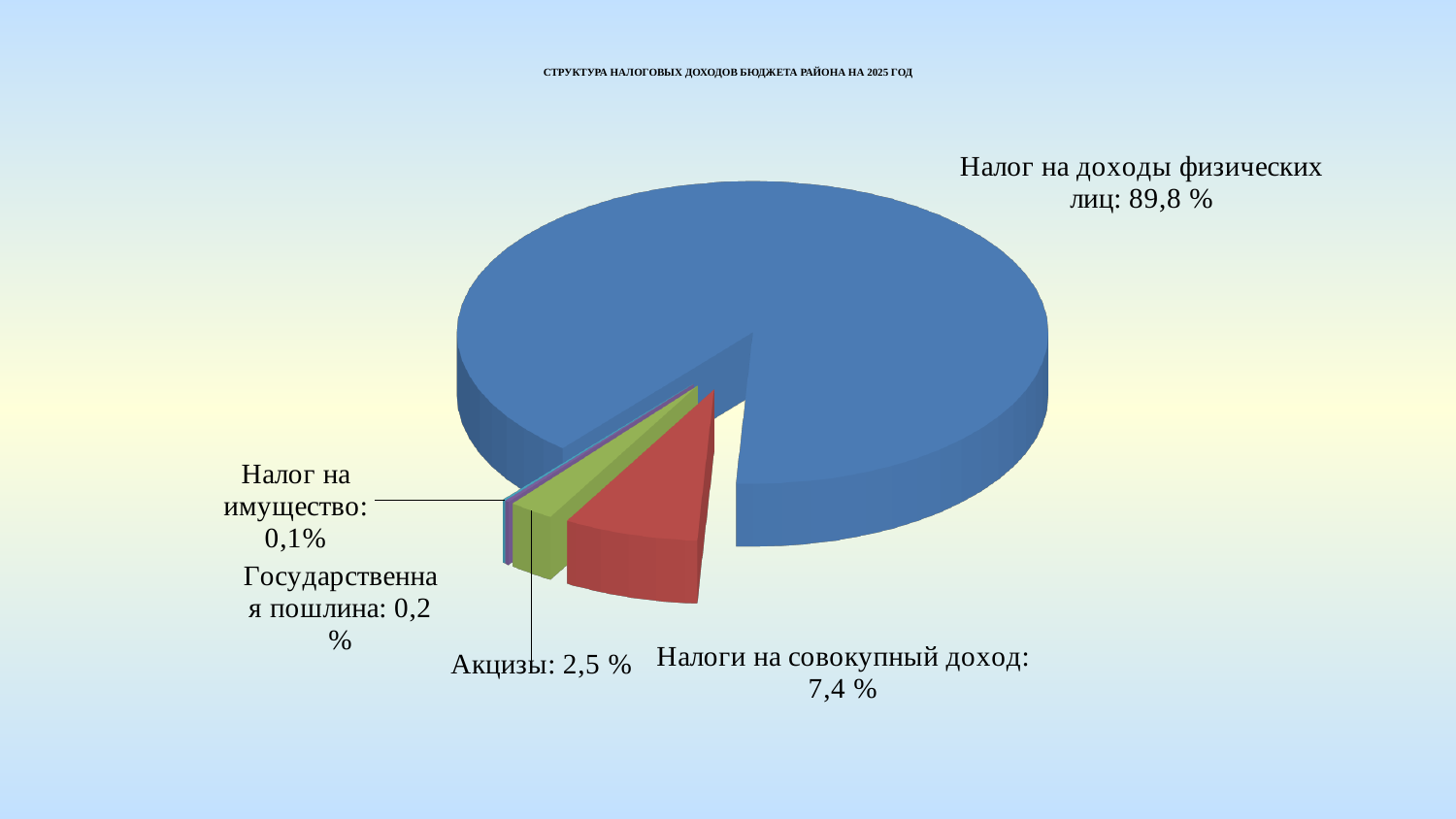
Сколько категорий (секторов) показано на круговой диаграмме? 5 Какой тип диаграммы показан на слайде? Круговая диаграмма Какая категория имеет наибольшую долю в структуре налоговых доходов? Налог на доходы физических лиц Какова доля государственной пошлины? 0,2 % Что больше: доля акцизов или доля государственной пошлины? Акцизы Каким цветом показан сектор налога на доходы физических лиц? Синим На сколько процентных пунктов доля налогов на совокупный доход больше доли акцизов? 4,9 Какова доля налога на доходы физических лиц в структуре налоговых доходов бюджета района на 2025 год? 89,8 % Какая категория имеет наименьшую долю в структуре налоговых доходов? Налог на имущество Какова доля акцизов? 2,5 % Какова доля налогов на совокупный доход? 7,4 % Какова доля налога на имущество? 0,1%